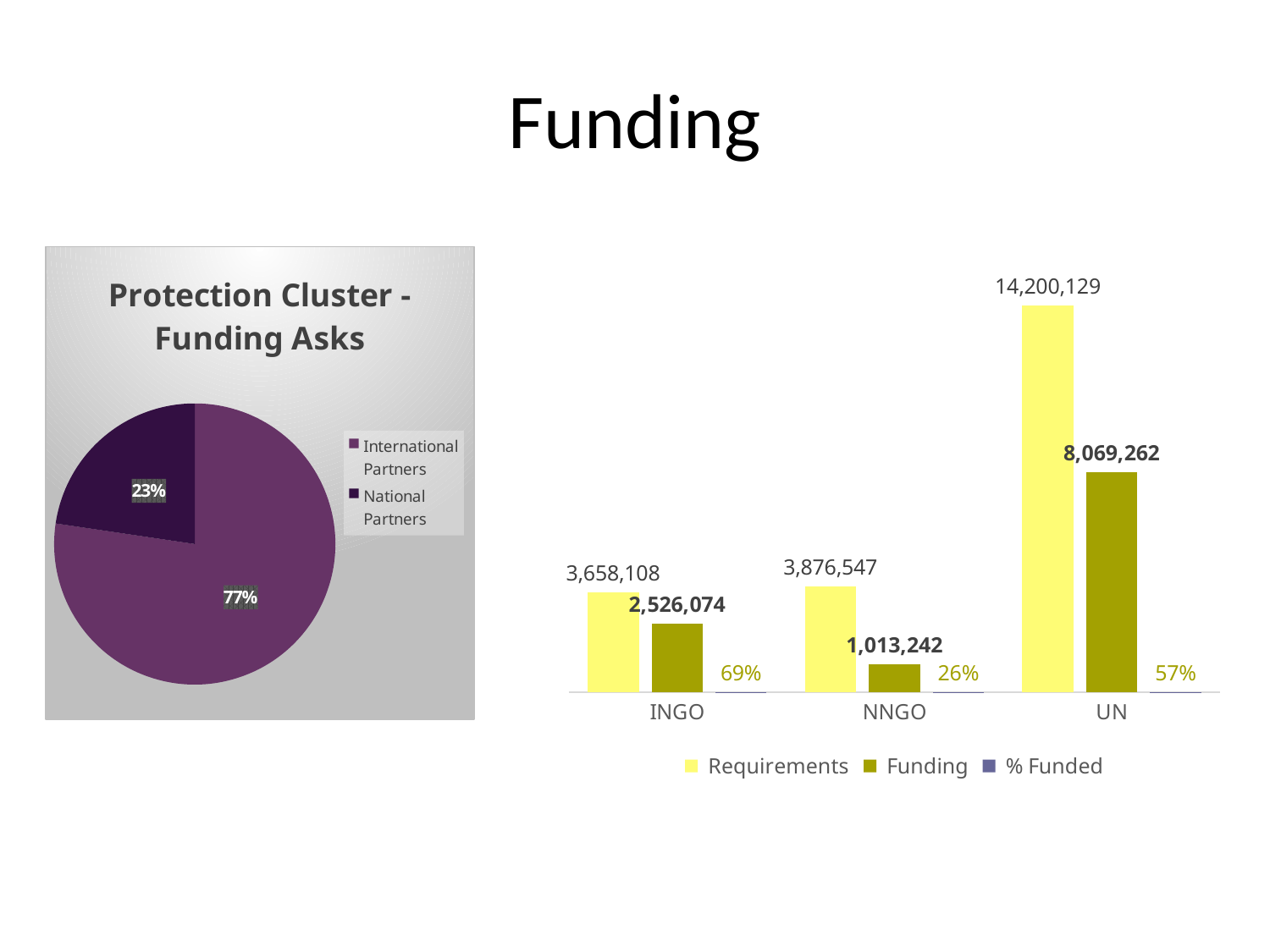
In the bar chart on the right, is the Funding for UN larger or smaller than the Funding for INGO? Larger In the bar chart on the right, what is the Requirements value for UN? 14,200,129 In the bar chart on the right, what is the difference between Requirements and Funding for INGO? 1,132,034 How many series does the legend of the bar chart on the right list? 3 In the bar chart on the right, what is the % Funded value for INGO? 69% In the bar chart on the right, which category has the highest Requirements? UN In the 'Protection Cluster - Funding Asks' pie chart, what share do International Partners have? 77% What kind of chart is the 'Protection Cluster - Funding Asks' chart on the left? Pie chart How many slices does the 'Protection Cluster - Funding Asks' pie chart have? 2 In the bar chart on the right, which category has the lowest % Funded? NNGO In the bar chart on the right, what is the Funding value for NNGO? 1,013,242 In the 'Protection Cluster - Funding Asks' pie chart, what share do National Partners have? 23%